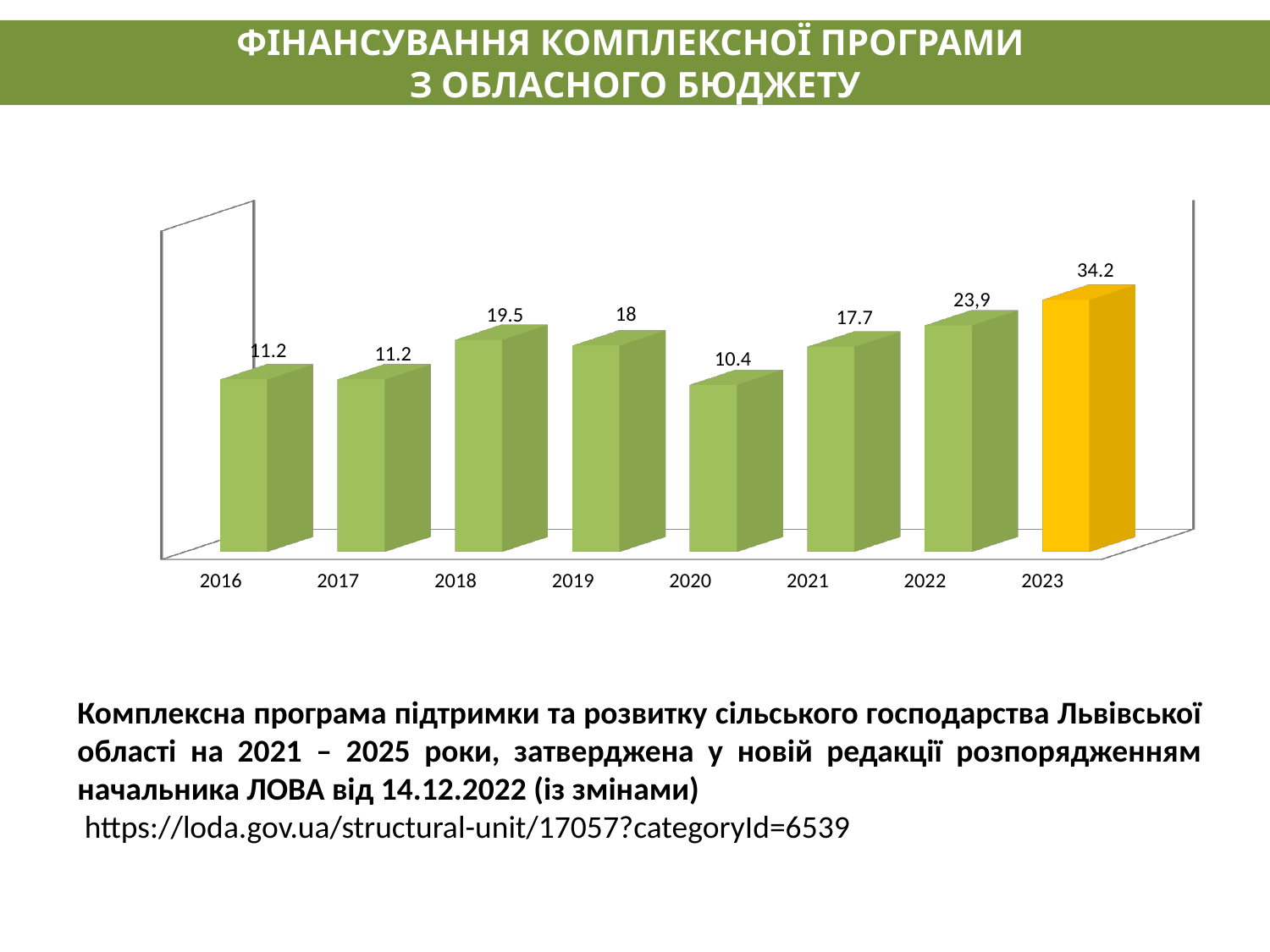
What is the value shown for 2022? 23,9 Which is larger, the value for 2019 or the value for 2021? 2019 What kind of chart is shown on the slide? bar chart Which year has the lowest value? 2020 What is the value shown for 2018? 19.5 What is the value shown for 2023? 34.2 What is the difference between the values for 2018 and 2019? 1.5 What is the value shown for 2020? 10.4 What is the difference between the values for 2023 and 2016? 23 How many years are shown on the x axis? 8 Do the values rise or fall from 2020 to 2023? rise Which year has the highest value? 2023